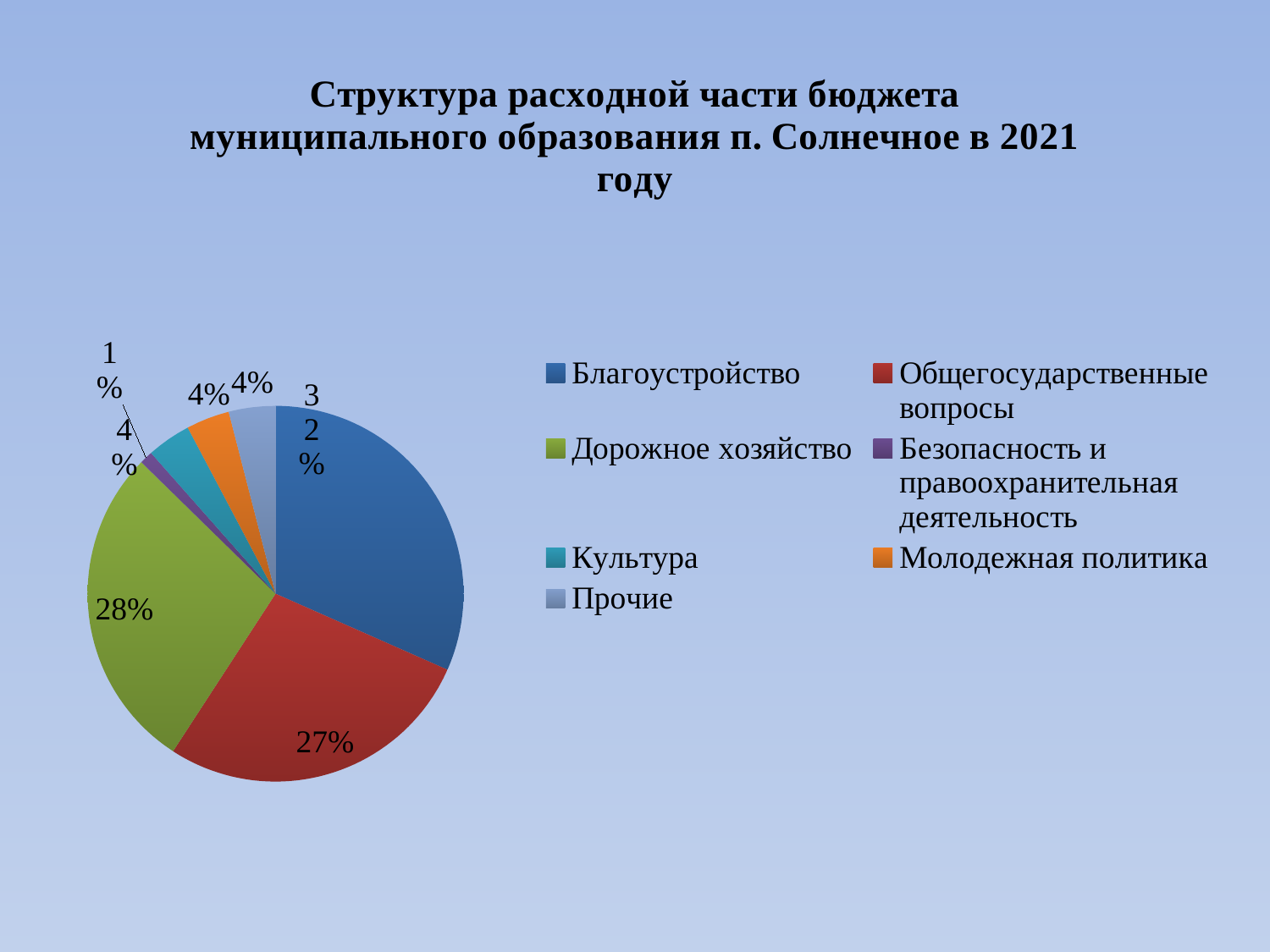
How many categories does the legend list? 7 What share of the budget expenditure goes to Безопасность и правоохранительная деятельность? 1% Which year does the chart title say the budget expenditure structure refers to? 2021 What is the difference in percentage points between Благоустройство and Общегосударственные вопросы? 5 What share of the budget expenditure goes to Общегосударственные вопросы? 27% Which is larger, the share for Дорожное хозяйство or the share for Общегосударственные вопросы? Дорожное хозяйство What kind of chart is shown on the slide? pie chart What share of the budget expenditure goes to Культура? 4% Which category has the largest share of the pie? Благоустройство What share of the budget expenditure goes to Дорожное хозяйство? 28% Which category has the smallest share of the pie? Безопасность и правоохранительная деятельность What share of the budget expenditure goes to Благоустройство? 32%